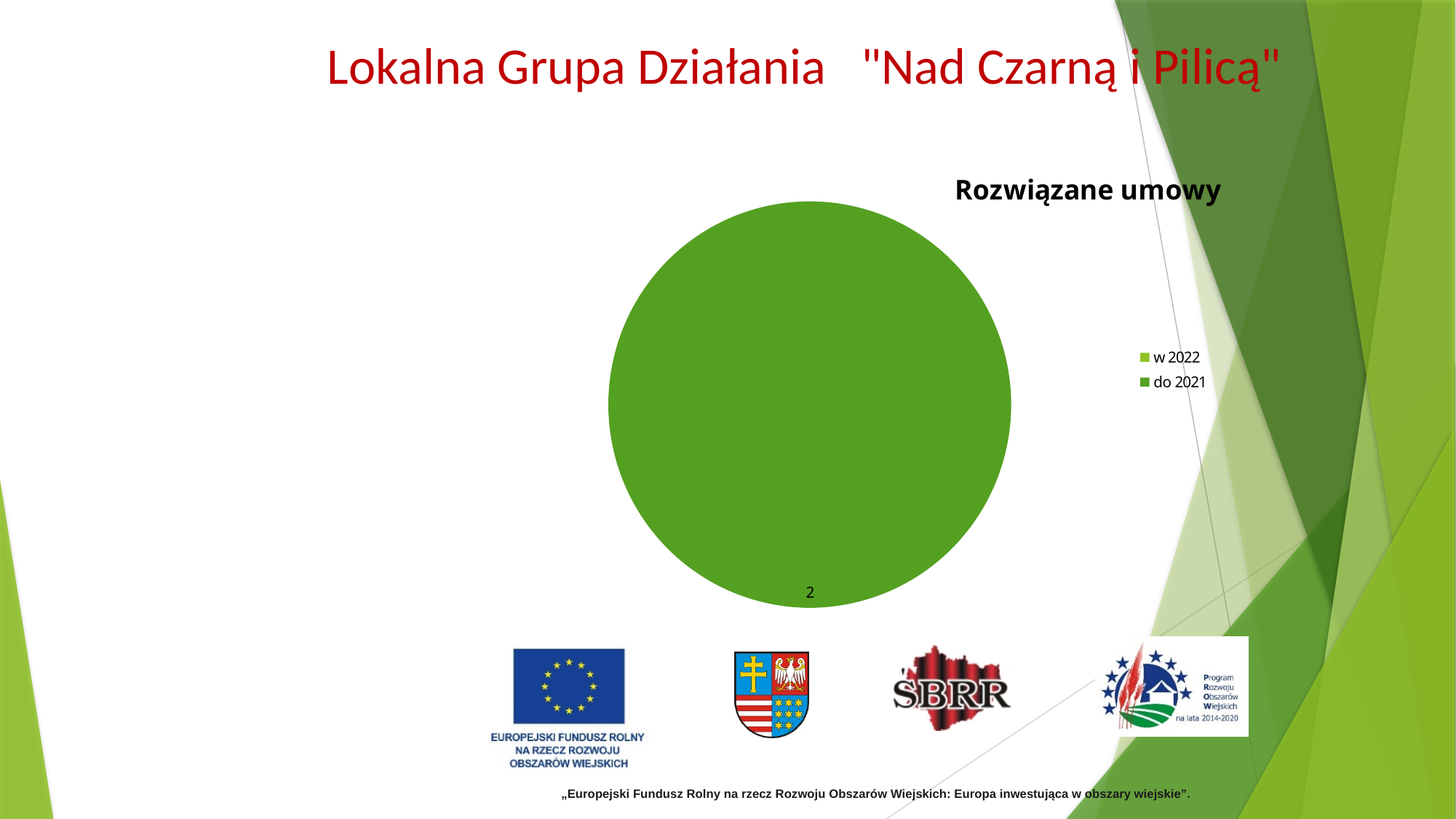
What is the title of the chart? Rozwiązane umowy What are the two entries listed in the chart's legend? w 2022 and do 2021 What data label value is printed on the pie chart? 2 What kind of chart is shown on the slide? pie chart How many visible slices does the pie chart have? 1 How many series does the chart's legend list? 2